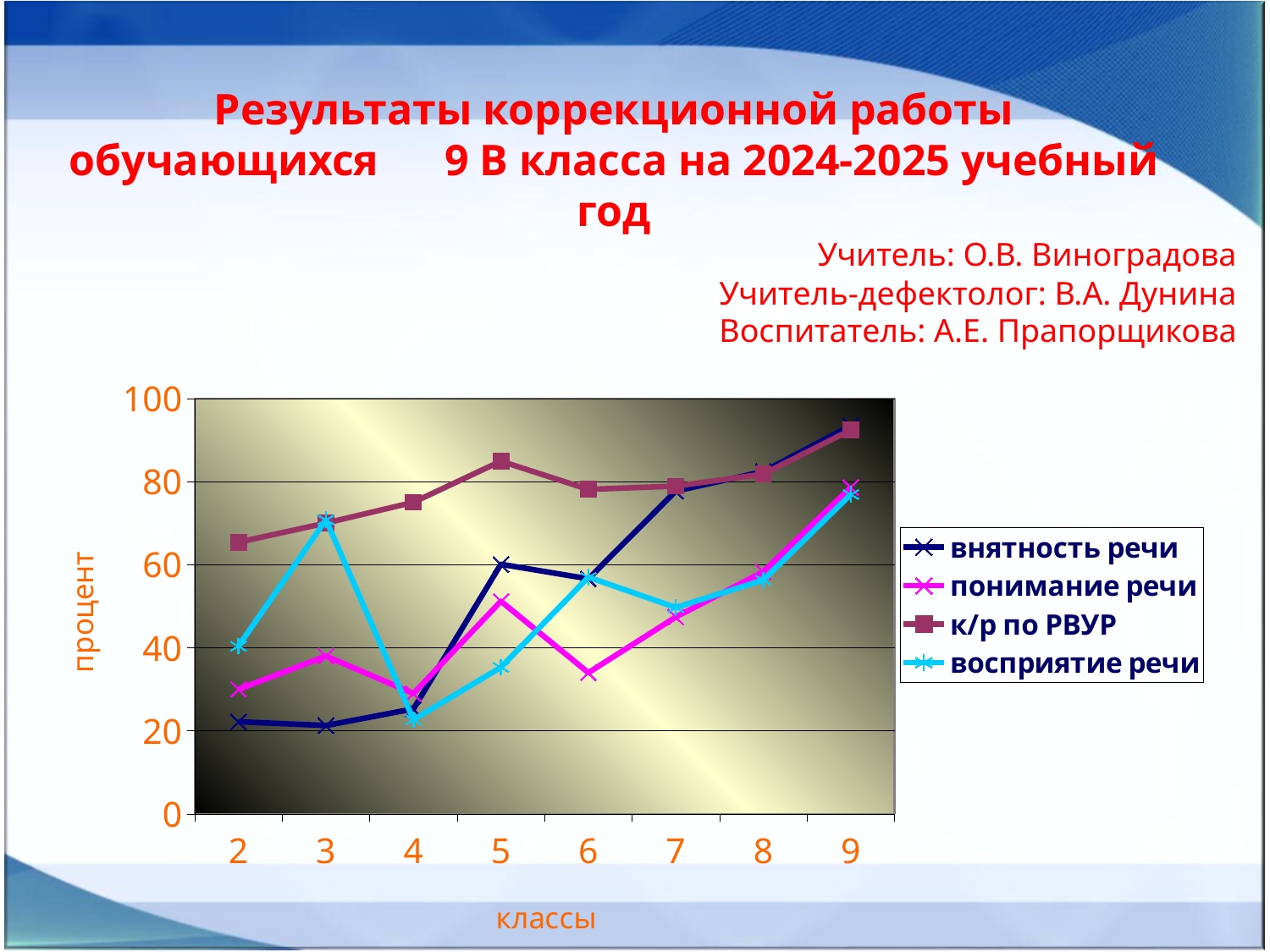
At class 3, which is larger: восприятие речи or понимание речи? восприятие речи How many series does the legend list? 4 Is the value for понимание речи at class 6 greater or less than 40? less Which series has the highest value at class 5? к/р по РВУР Is the value for внятность речи at class 9 greater or less than 80? greater What is the title of the vertical axis? процент How many classes are shown along the x axis? 8 Is the value for внятность речи at class 2 greater or less than 40? less What kind of chart is shown on the slide? line chart Which series has the lowest value at class 2? внятность речи Does the к/р по РВУР line rise or fall from class 2 to class 5? rise